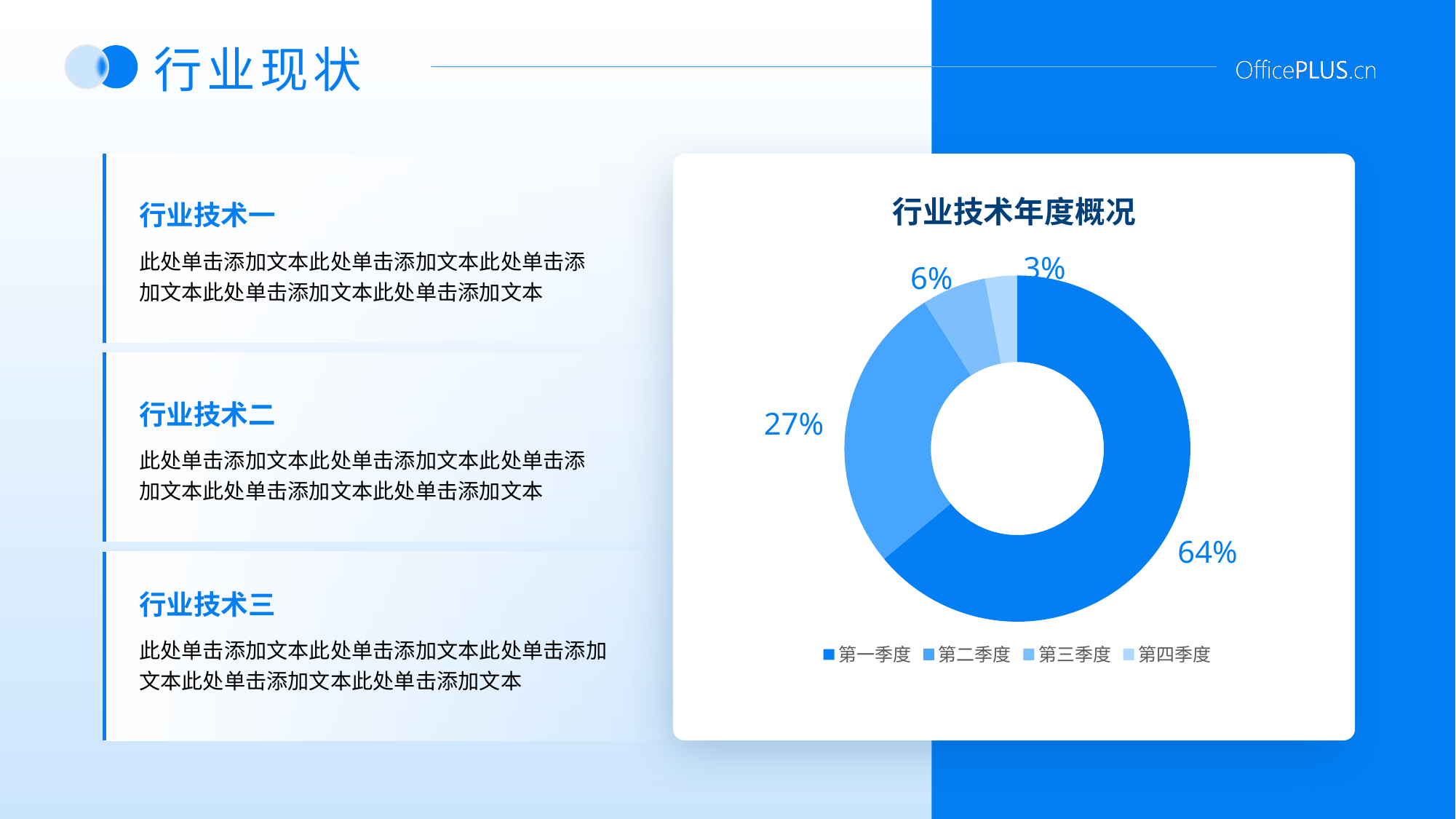
What is the difference between the values for 第三季度 and 第四季度? 3% What is the value for 第三季度 in the chart? 6% What is the value for 第二季度 in the chart? 27% Which category has the largest share in the chart? 第一季度 Which is larger, the value for 第二季度 or the value for 第三季度? 第二季度 How many categories does the chart show? 4 What kind of chart is shown on the slide? Doughnut chart Which category has the smallest share in the chart? 第四季度 What is the title of the chart? 行业技术年度概况 What is the value for 第四季度 in the chart? 3% What is the difference between the values for 第一季度 and 第二季度? 37% What is the value for 第一季度 in the chart? 64%